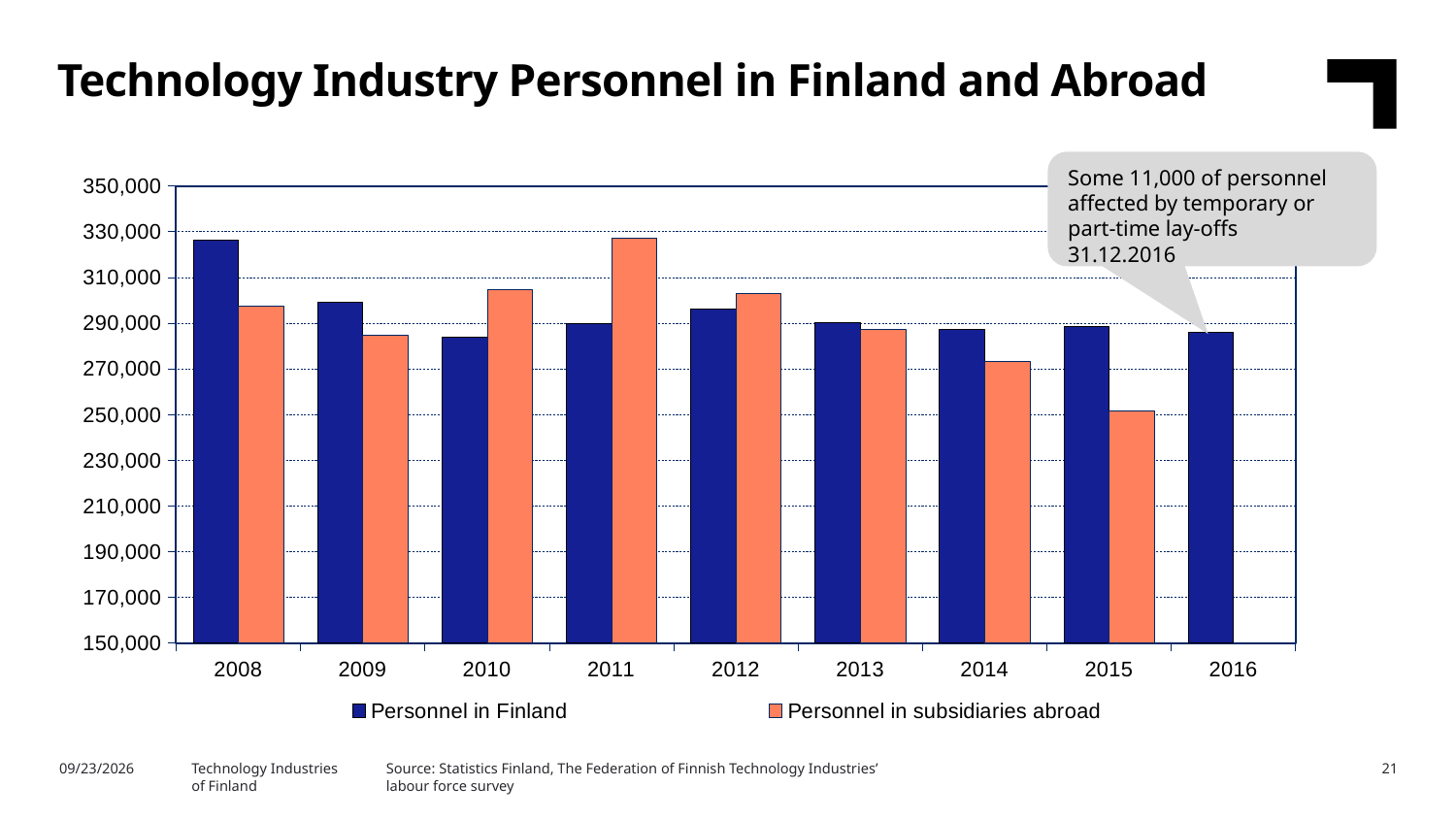
What kind of chart is shown on the slide? Bar chart In which year is Personnel in Finland highest? 2008 In 2015, which is larger: Personnel in Finland or Personnel in subsidiaries abroad? Personnel in Finland Is the value for Personnel in Finland in 2008 greater or less than 310,000? greater In which year is Personnel in subsidiaries abroad lowest? 2015 Is the value for Personnel in subsidiaries abroad in 2014 greater or less than 290,000? less How many series does the legend list? 2 In which year is Personnel in subsidiaries abroad highest? 2011 How many years are shown on the x axis? 9 Is the value for Personnel in subsidiaries abroad in 2015 greater or less than 270,000? less In 2010, which is larger: Personnel in Finland or Personnel in subsidiaries abroad? Personnel in subsidiaries abroad Does Personnel in subsidiaries abroad rise or fall from 2011 to 2015? Fall